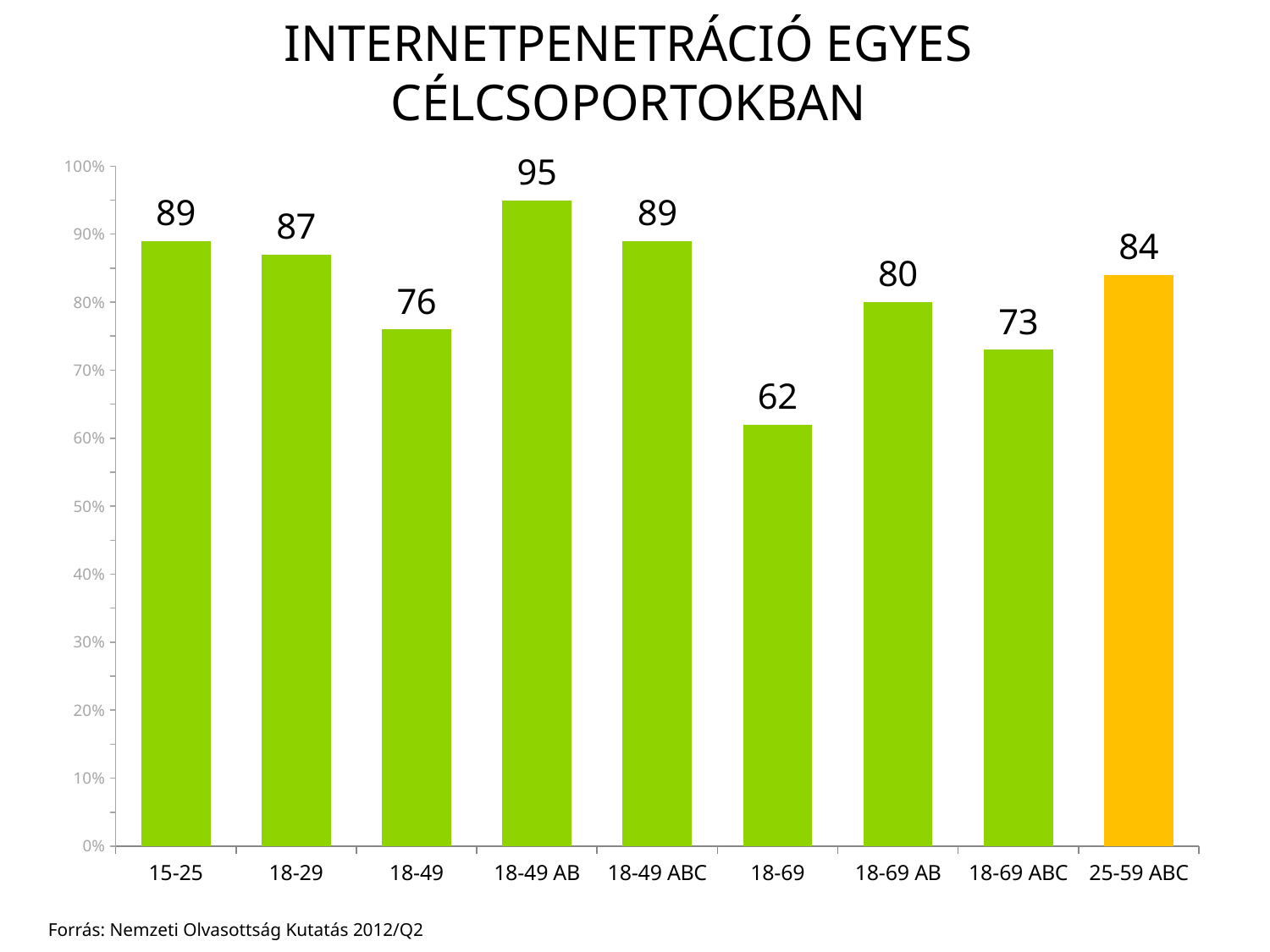
Which is larger, the value for 18-69 AB or the value for 18-69 ABC? 18-69 AB What is the value for the 25-59 ABC category? 84 Which category has the lowest value? 18-69 What kind of chart is shown on the slide? bar chart What is the difference between the values for 15-25 and 18-49? 13 Which category has the highest value? 18-49 AB Is the value for 18-29 greater or less than 80%? greater What is the value for the 18-69 category? 62 Which category's bar is coloured differently (orange) from the others? 25-59 ABC How many categories are shown on the x axis? 9 What is the value for the 18-49 AB category? 95 What is the difference between the values for 18-49 AB and 18-69? 33